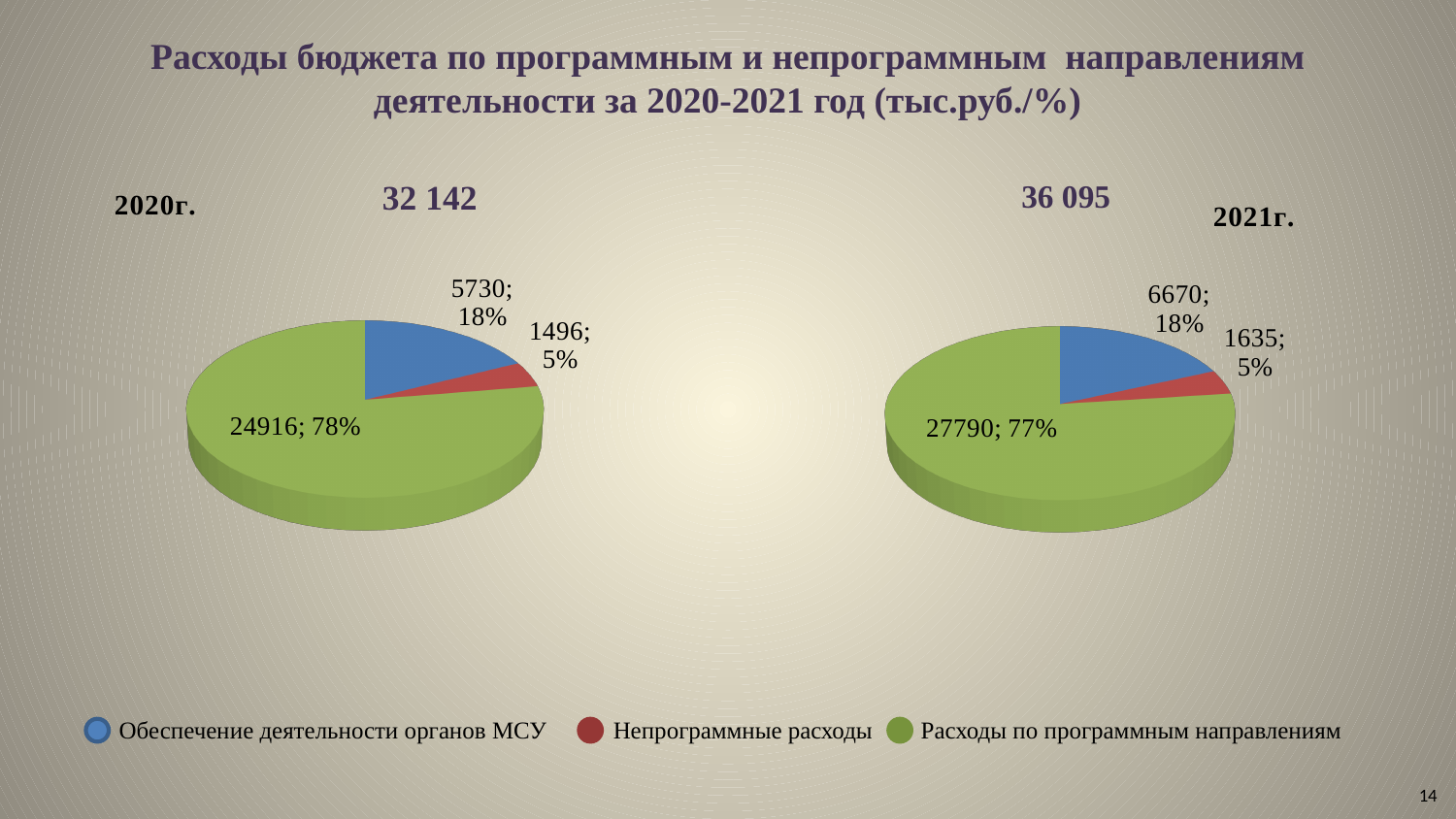
How many categories does the legend list for the pie charts? 3 In the 2021г. pie chart, which category has the largest slice? Расходы по программным направлениям In the 2021г. pie chart, what value is shown for Непрограммные расходы? 1635; 5% What share of the 2020г. pie does Обеспечение деятельности органов МСУ take? 18% What total is printed above the 2021г. pie chart? 36 095 What share of the 2021г. pie does Расходы по программным направлениям take? 77% Which is larger: Непрограммные расходы in the 2020г. chart or in the 2021г. chart? 2021г. In the 2020г. pie chart, which category has the smallest slice? Непрограммные расходы What type of chart is used for the 2020г. data on the left? Pie chart In the 2020г. pie chart, what value is shown for Расходы по программным направлениям? 24916; 78% In the 2021г. pie chart, what value is shown for Обеспечение деятельности органов МСУ? 6670; 18% What is the difference between the Обеспечение деятельности органов МСУ values in the 2021г. and 2020г. pie charts? 940